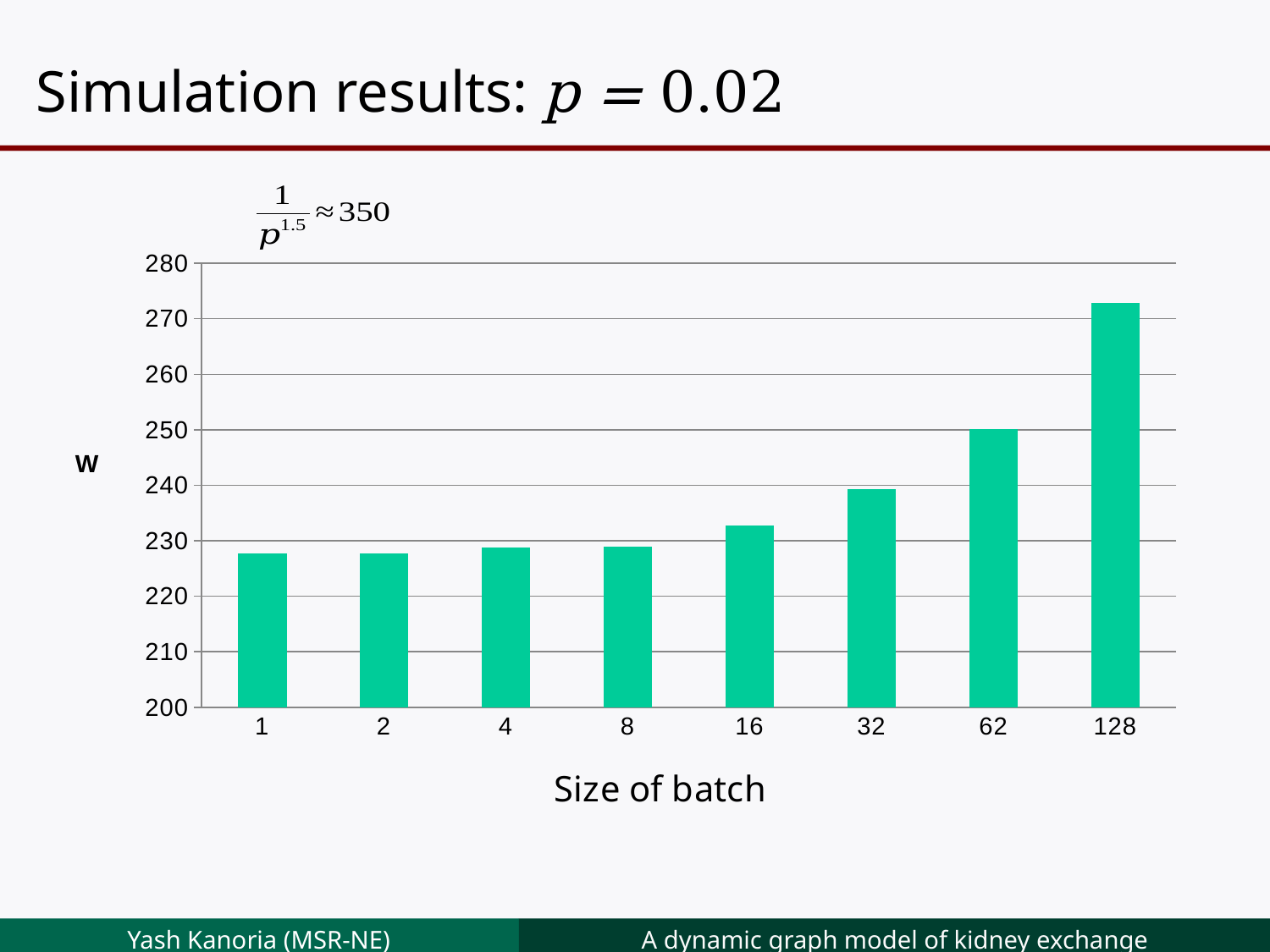
Which has a larger value of w: batch size 8 or batch size 128? 128 Which size of batch has the highest value of w? 128 Is the value of w for batch size 1 greater or less than 240? less Is the value of w for batch size 128 greater or less than 260? greater Do the values of w rise or fall as the size of batch increases along the x axis? rise What is the title of the x axis? Size of batch Which has a larger value of w: batch size 62 or batch size 32? 62 What kind of chart is shown on the slide? bar chart Is the value of w for batch size 16 greater or less than 240? less What label is shown on the y axis? w How many batch sizes are plotted on the x axis? 8